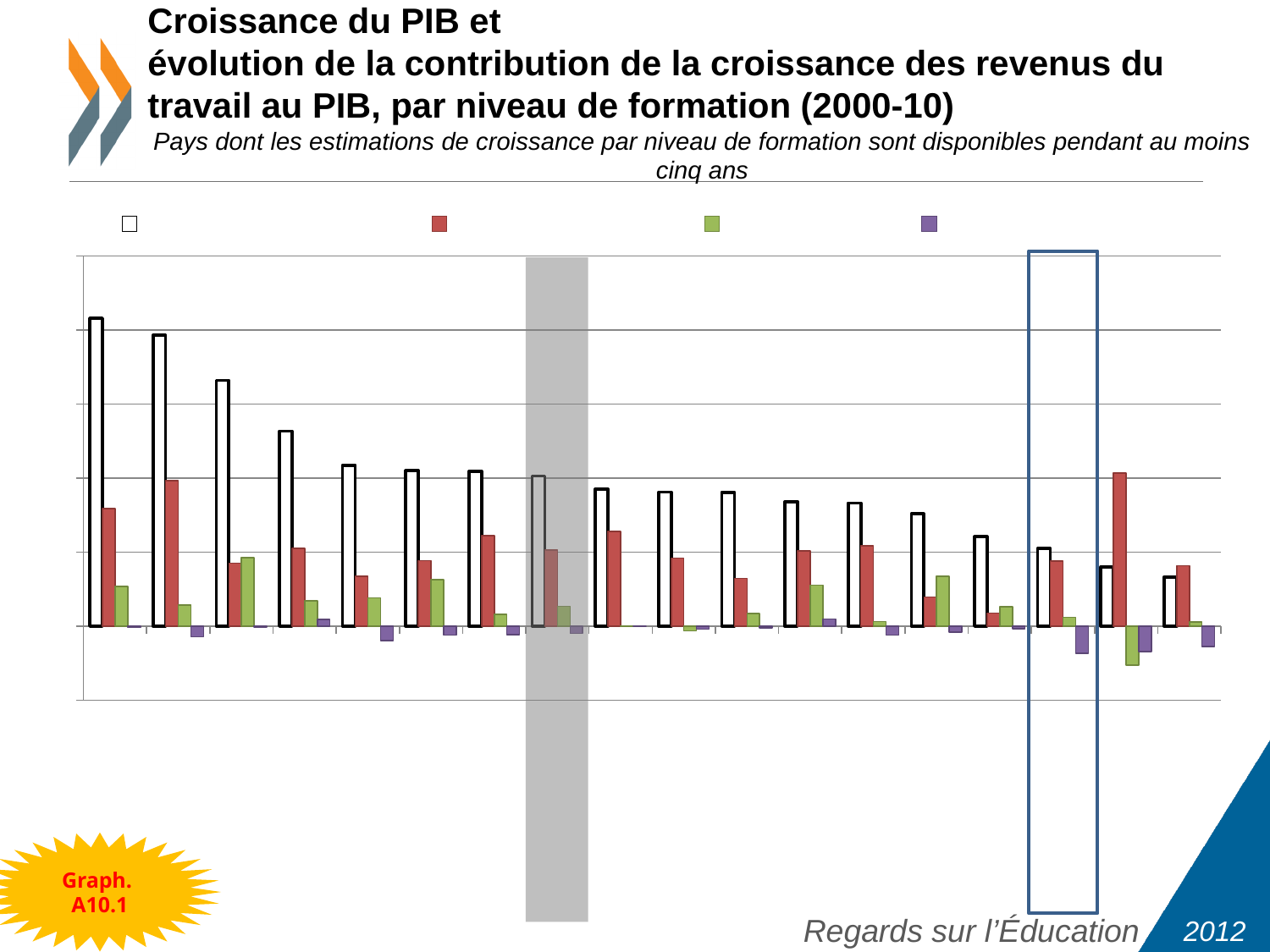
What kind of chart is shown on the slide? bar chart In the second group of bars from the right, which is taller: the white bar or the red bar? the red bar What period does the chart title say the data covers? 2000-10 How many series does the legend show? 4 What figure reference is shown in the starburst at the bottom left of the slide? Graph. A10.1 Do the white bars rise or fall from left to right along the x axis? fall In the leftmost group of bars, which is taller: the white bar or the red bar? the white bar How many groups of bars are plotted along the x axis? 18 Which group of bars has the tallest white bar? the leftmost group